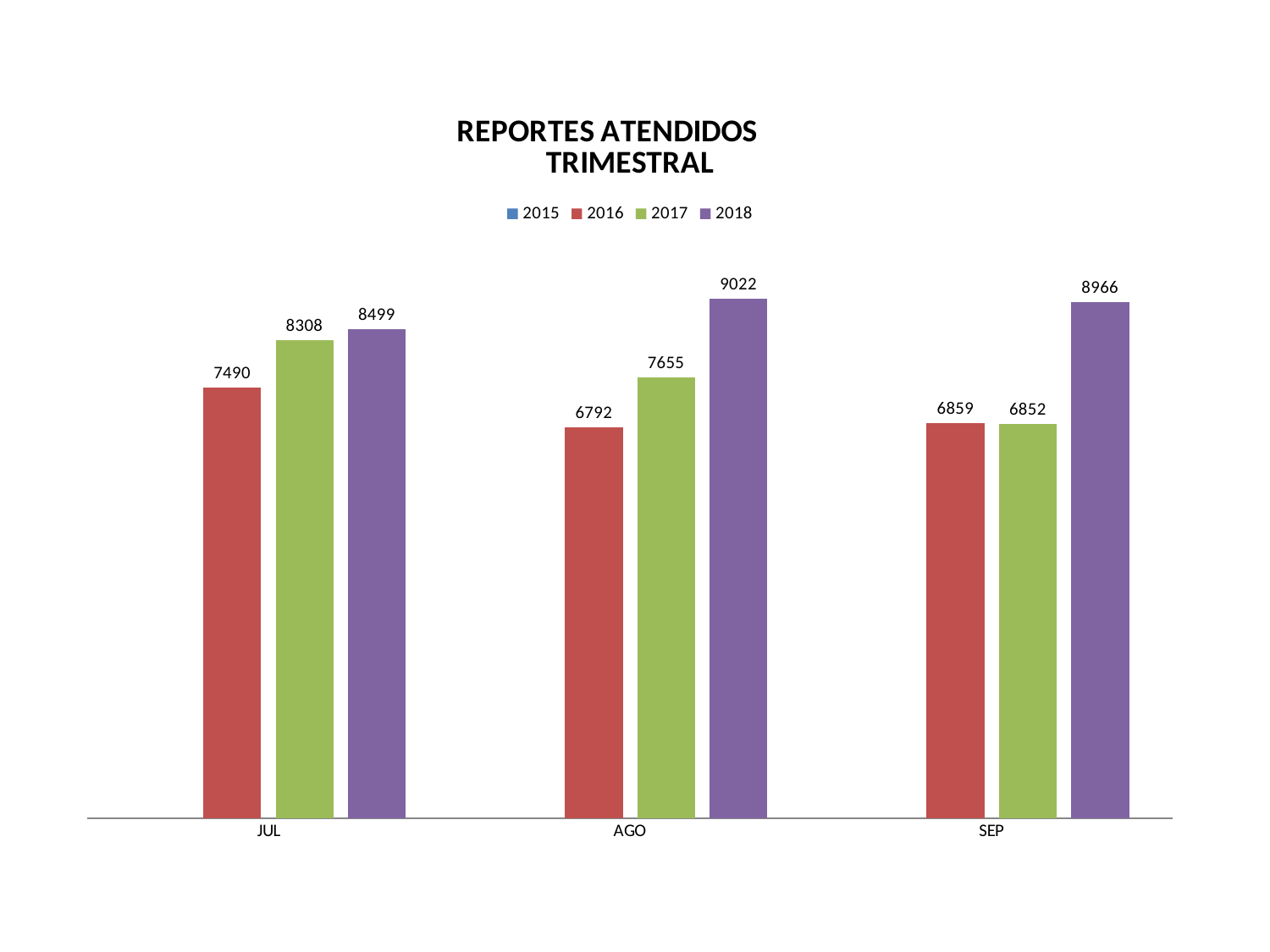
How many months are shown on the x axis? 3 What is the value for 2018 in AGO? 9022 What is the difference between the 2017 and 2016 values in JUL? 818 Which is larger in SEP, the value for 2018 or the value for 2016? 2018 What is the difference between the 2018 and 2017 values in AGO? 1367 How many series does the legend list? 4 What is the title of the chart? REPORTES ATENDIDOS TRIMESTRAL What is the value for 2017 in SEP? 6852 Which month has the highest value for 2018? AGO What is the value for 2016 in JUL? 7490 What kind of chart is shown on the slide? bar chart Which month has the lowest value for 2016? AGO